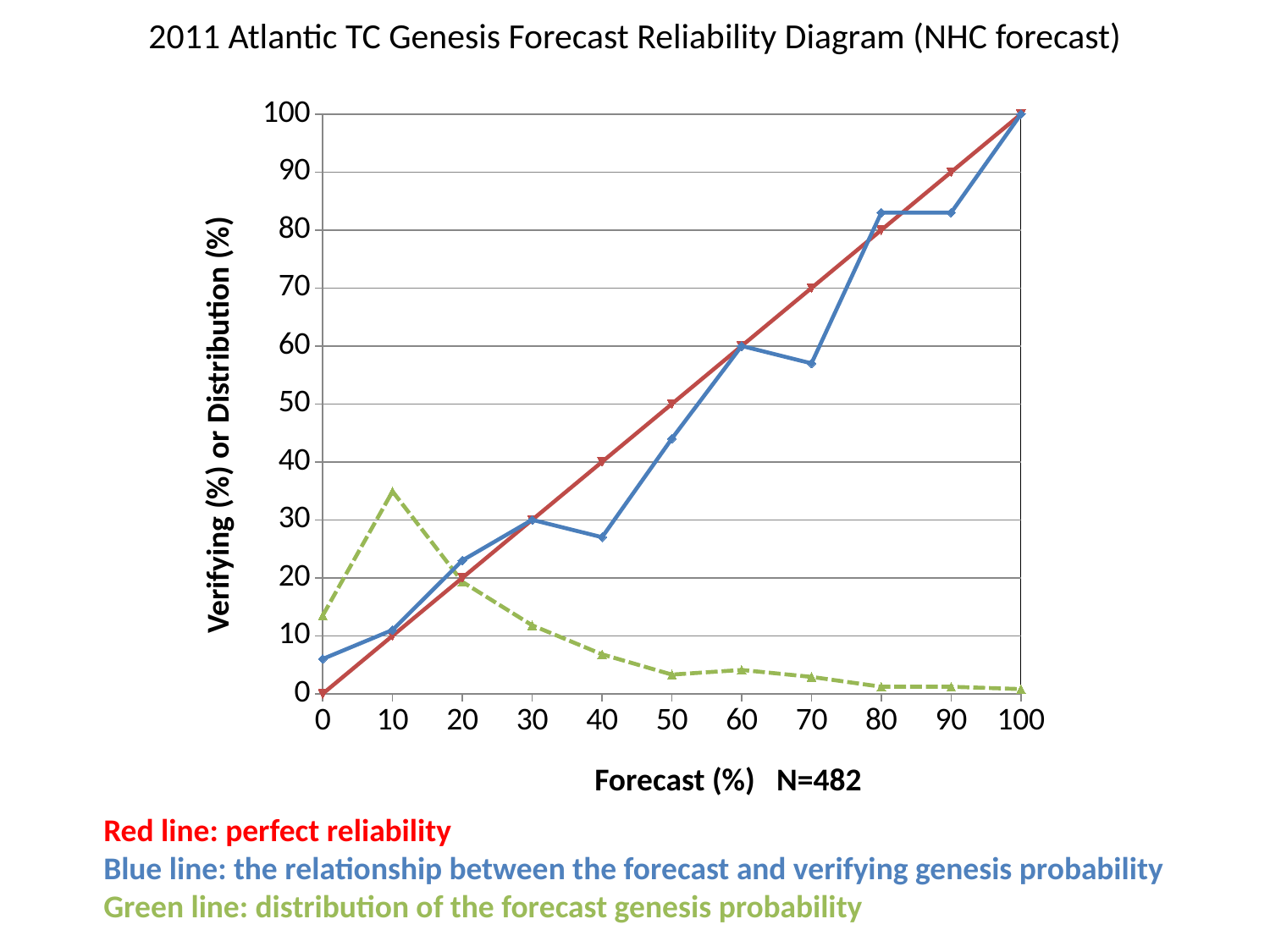
How many lines are plotted on the chart? 3 Is the value of the green line at a forecast of 50% greater or less than 10? less What sample size N is given in the x-axis label? N=482 What is the value of the blue line at a forecast of 30%? 30 How many forecast values are marked along the x axis? 11 Is the value of the green line at a forecast of 10% greater or less than 30? greater At which forecast value does the green line reach its highest point? 10 Does the green line rise or fall as the forecast increases from 10% to 100%? fall What is the value of the red line at a forecast of 50%? 50 What kind of chart is shown on the slide? line chart At a forecast of 40%, which line has the higher value, the red line or the blue line? red line Is the value of the blue line at a forecast of 70% greater or less than 60? less